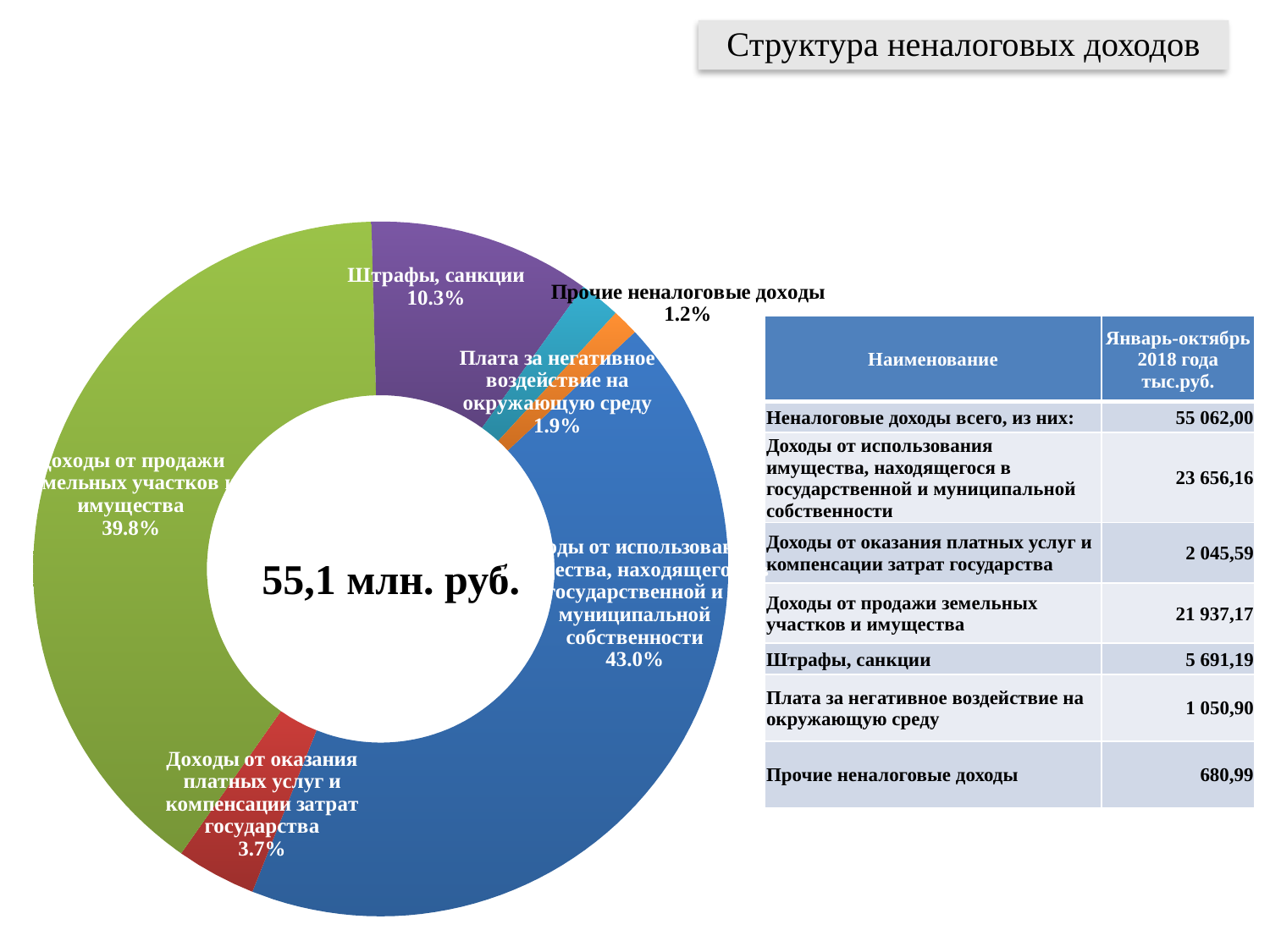
Which category has the smallest share in the doughnut chart? Прочие неналоговые доходы How many categories (slices) does the doughnut chart have? 6 What share of the doughnut chart does "Штрафы, санкции" represent? 10.3% What share of the doughnut chart does "Доходы от оказания платных услуг и компенсации затрат государства" represent? 3.7% Which category has the largest share in the doughnut chart? Доходы от использования имущества, находящегося в государственной и муниципальной собственности What share of the doughnut chart does "Плата за негативное воздействие на окружающую среду" represent? 1.9% What is the difference in percentage points between the share of "Штрафы, санкции" and the share of "Доходы от оказания платных услуг и компенсации затрат государства"? 6.6 percentage points What total value is printed in the centre of the doughnut chart? 55,1 млн. руб. Which is larger in the doughnut chart: the share of "Штрафы, санкции" or the share of "Плата за негативное воздействие на окружающую среду"? Штрафы, санкции What share of the doughnut chart does "Прочие неналоговые доходы" represent? 1.2% What kind of chart is shown on the slide? Doughnut (pie) chart What is the title of the slide containing the doughnut chart? Структура неналоговых доходов